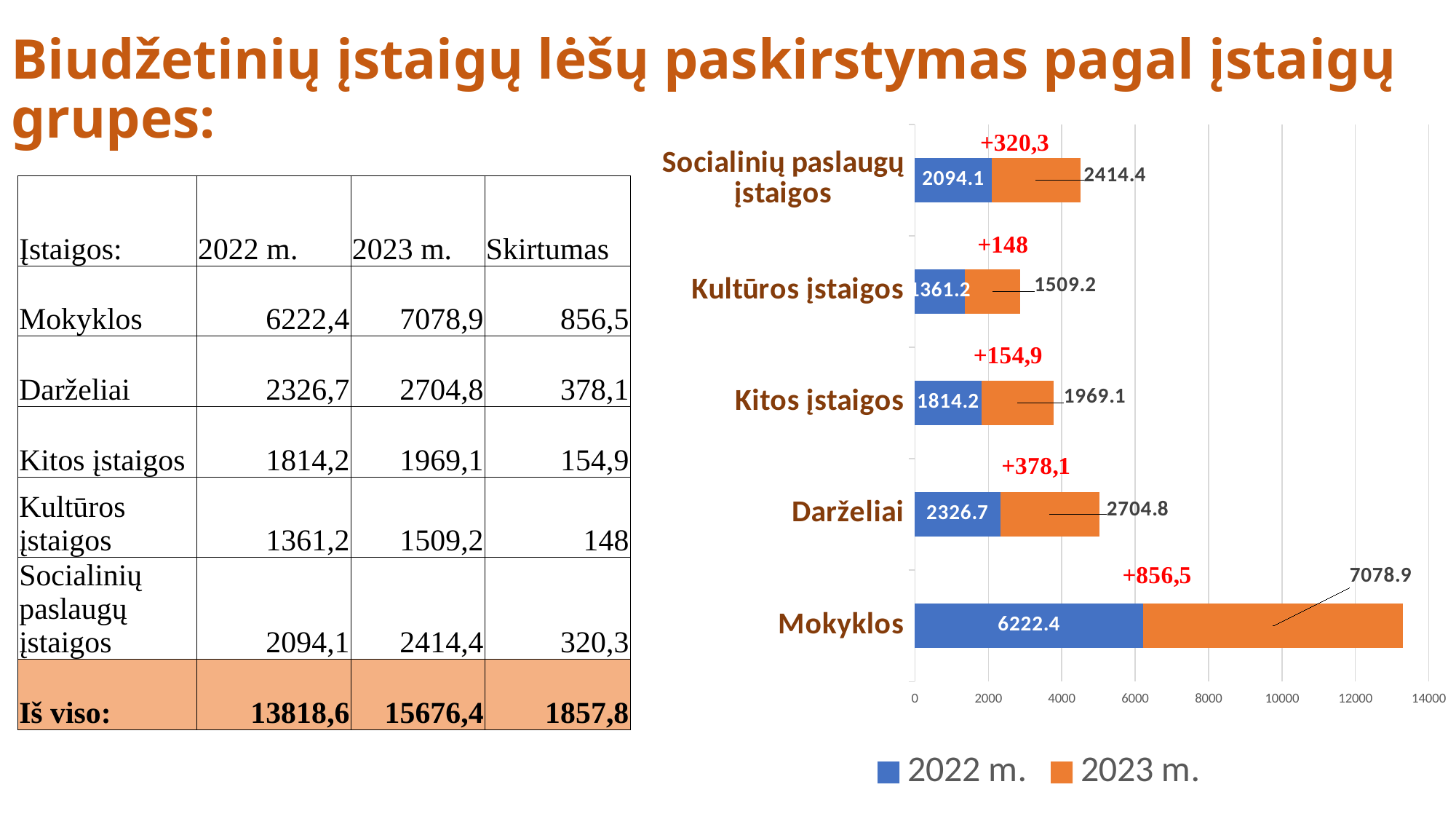
What is the 2022 m. value for Kultūros įstaigos in the chart? 1361.2 How many categories are plotted in the chart? 5 What is the total of the stacked bar for Darželiai in the chart? 5031.5 Which category has the highest 2023 m. value in the chart? Mokyklos Which is larger in the chart: the 2022 m. value for Darželiai or the 2022 m. value for Socialinių paslaugų įstaigos? Darželiai How many series does the chart legend list? 2 What is the 2023 m. value for Darželiai in the chart? 2704.8 What is the 2023 m. value for Socialinių paslaugų įstaigos in the chart? 2414.4 What is the 2022 m. value for Mokyklos in the chart? 6222.4 What type of chart is shown on the slide? bar chart What is the difference between the 2023 m. and 2022 m. values for Kitos įstaigos in the chart? 154.9 Which category has the lowest 2022 m. value in the chart? Kultūros įstaigos